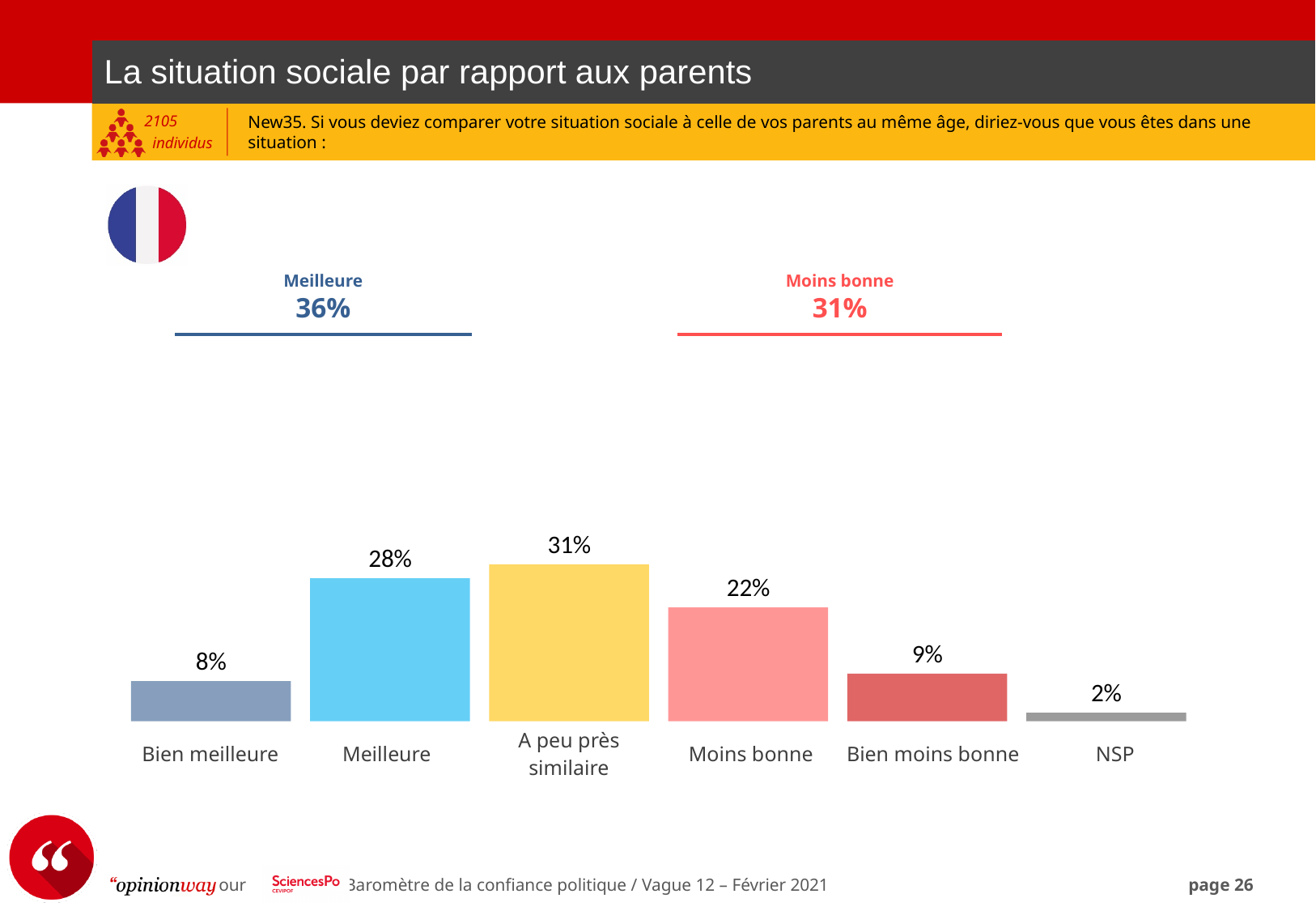
Which category has the highest value? A peu près similaire What is the value for "A peu près similaire"? 31% What kind of chart is shown on the slide? Bar chart What combined percentage is shown above the chart for "Meilleure"? 36% What is the value for "Moins bonne"? 22% How many categories are shown in the bar chart? 6 What combined percentage is shown above the chart for "Moins bonne"? 31% Which is larger, the value for "Bien moins bonne" or the value for "Bien meilleure"? Bien moins bonne Which category has the lowest value? NSP What is the value for "Bien meilleure"? 8% What is the value for "NSP"? 2% What is the difference between the values for "Meilleure" and "Moins bonne"? 6%